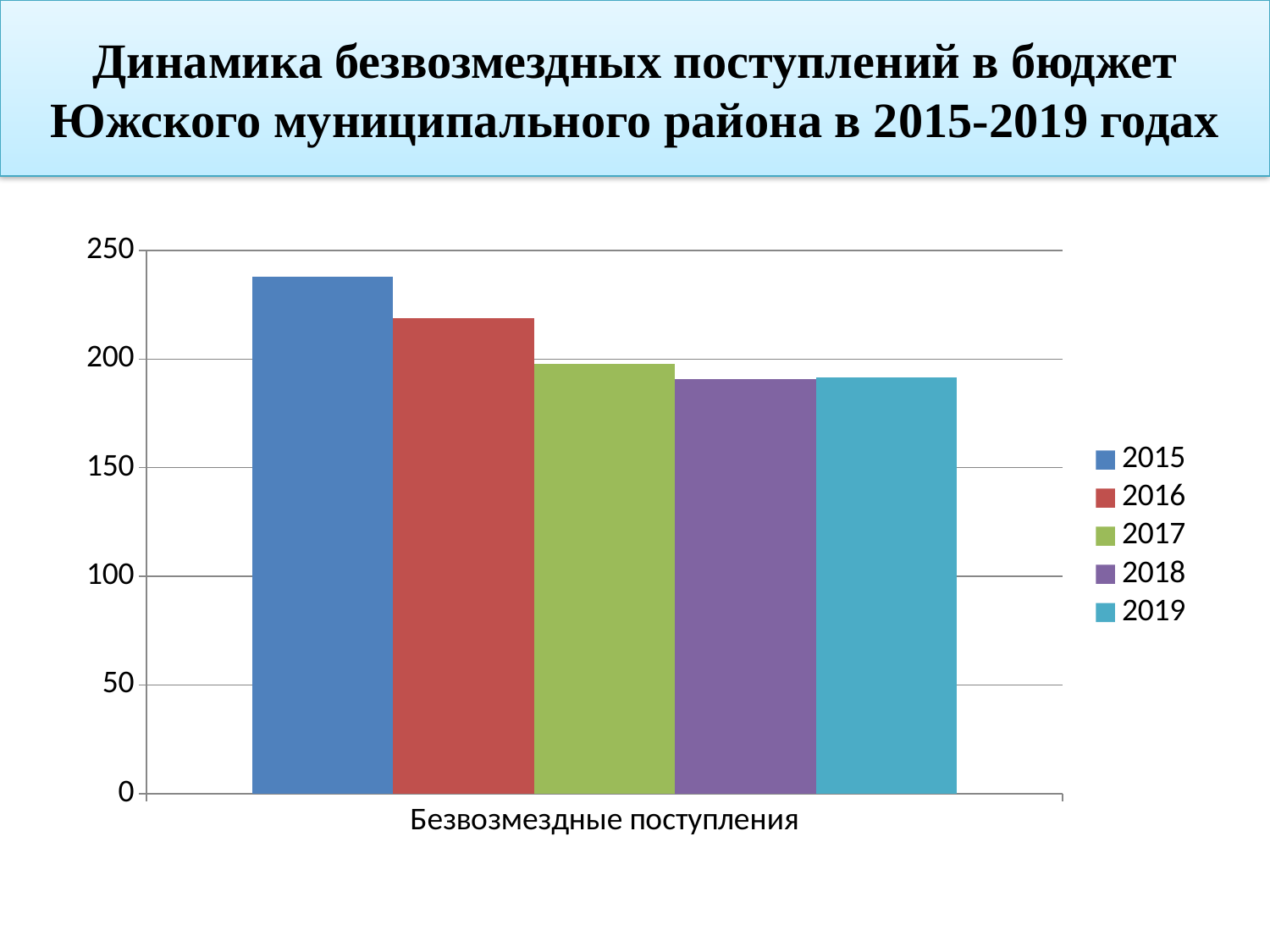
Is the value for 2015 greater or less than 200? greater Is the value for 2016 greater or less than 200? greater What kind of chart is shown on the slide? bar chart How many series does the legend list? 5 Do the values generally rise or fall from 2015 to 2019? fall Which is larger, the value for 2015 or the value for 2016? 2015 How many categories are shown on the x axis? 1 What is the label of the category on the x axis? Безвозмездные поступления Which year has the highest value for Безвозмездные поступления? 2015 Which is larger, the value for 2016 or the value for 2018? 2016 Is the value for 2018 greater or less than 200? less